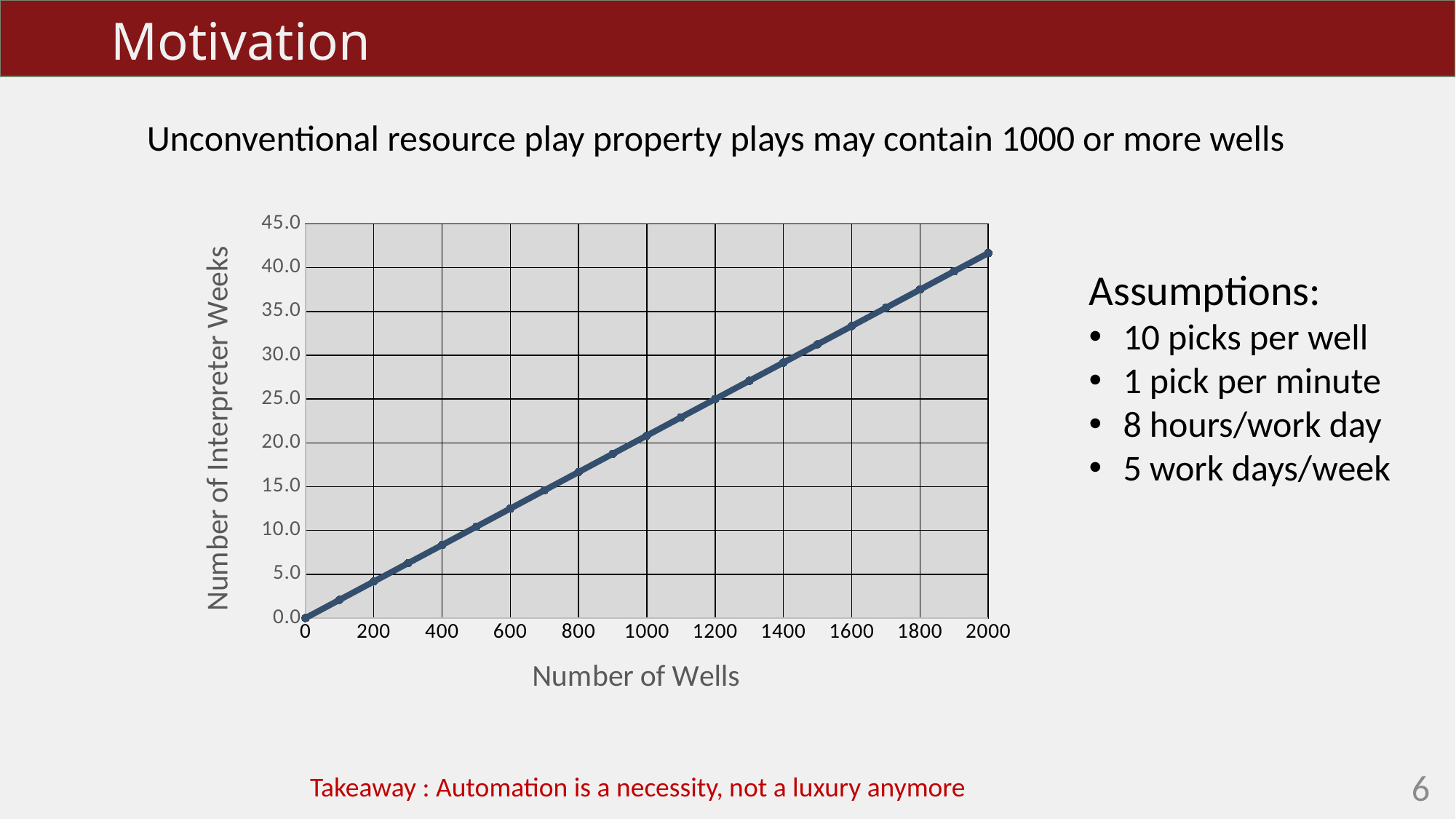
Which has more interpreter weeks: 800 wells or 1400 wells? 1400 wells What is the number of interpreter weeks at 0 wells? 0.0 What is the title of the x axis? Number of Wells At which number of wells is the number of interpreter weeks highest? 2000 Is the number of interpreter weeks for 1600 wells greater or less than 35.0? less At which number of wells is the number of interpreter weeks lowest? 0 Is the number of interpreter weeks for 400 wells greater or less than 10.0? less Is the number of interpreter weeks for 1000 wells greater or less than 20.0? greater Do the values rise or fall as the number of wells increases? rise What kind of chart is shown on the slide? line chart What is the title of the y axis? Number of Interpreter Weeks